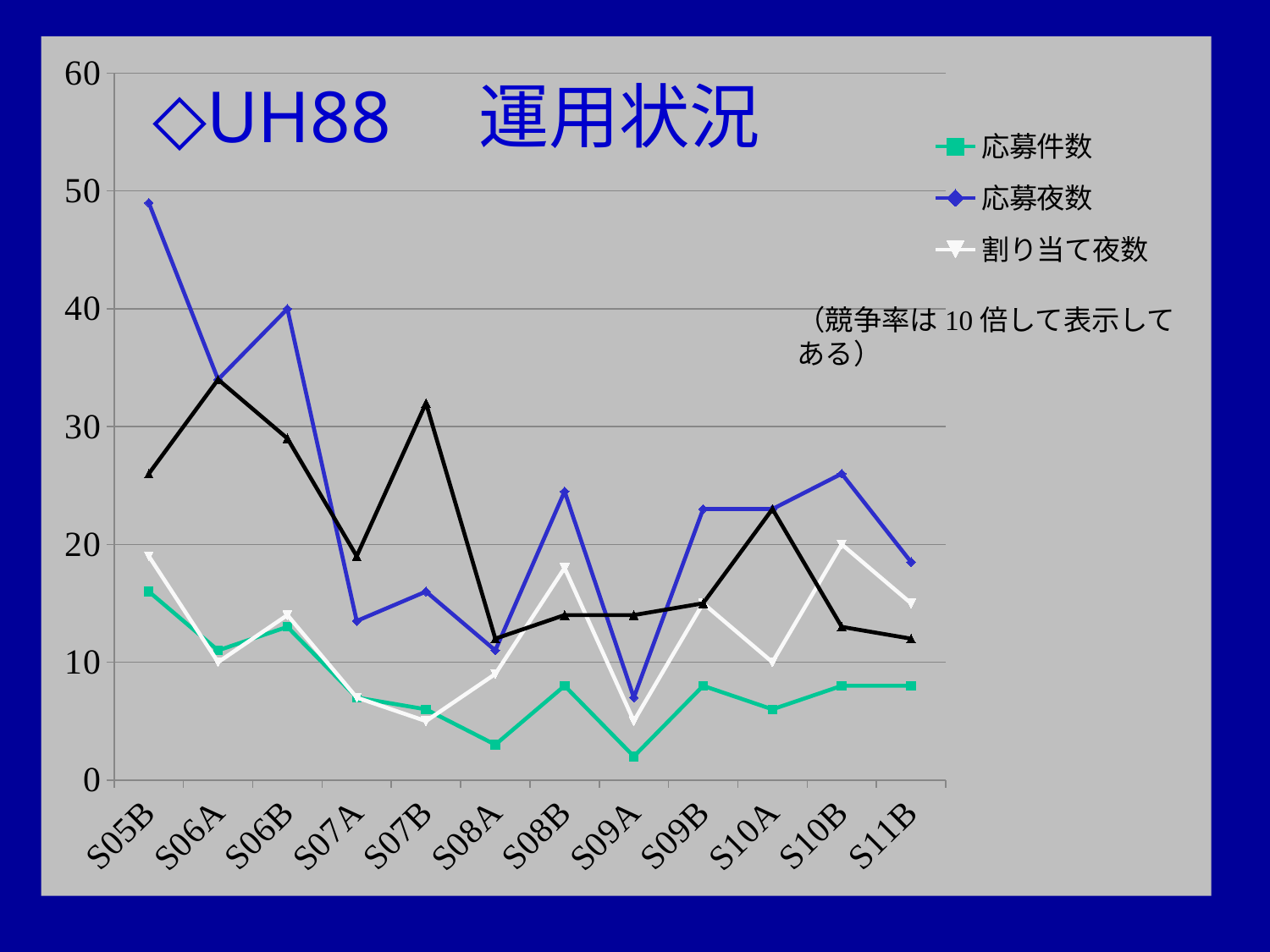
What colour is the 応募件数 line in the legend? green Does 応募件数 generally rise or fall from S05B to S11B? fall Is the value of 応募夜数 at S10B greater or less than 20? greater What kind of chart is shown on the slide? line chart Is the value of 応募件数 at S09A greater or less than 10? less How many categories are shown on the x axis? 12 At which category is 応募夜数 highest? S05B At which category is 応募件数 lowest? S09A How many series does the legend list? 3 Is the value of 応募夜数 at S05B greater or less than 40? greater At which category is 割り当て夜数 lowest? S07B and S09A (tied at 5) At S10B, which is larger: 割り当て夜数 or 応募件数? 割り当て夜数